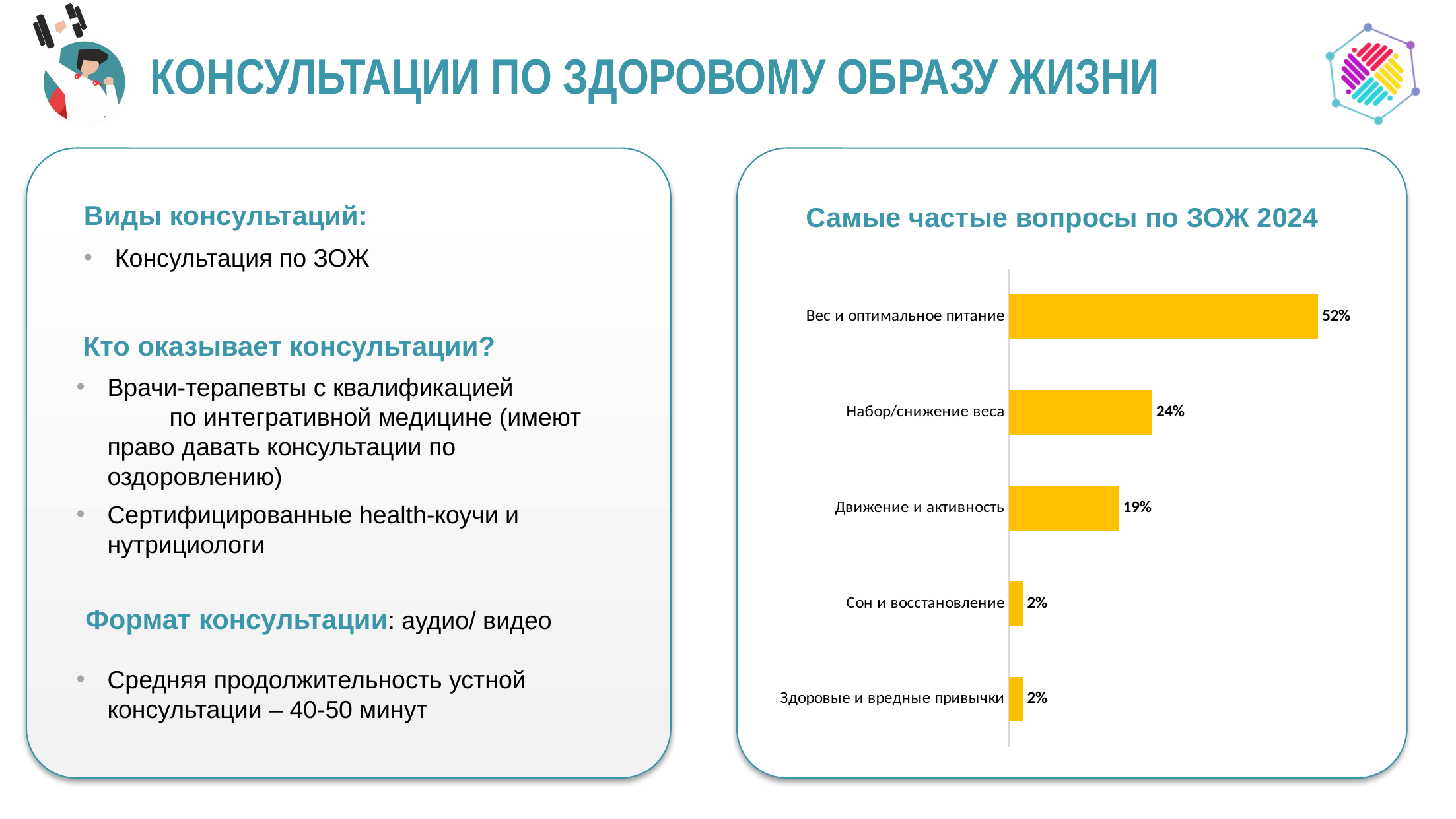
How many categories are shown in the chart? 5 What colour are the bars in the chart? Yellow Which category has the highest value? Вес и оптимальное питание What kind of chart is shown on the slide? Bar chart What is the value for Вес и оптимальное питание? 52% What is the value for Набор/снижение веса? 24% Which is larger, Движение и активность or Сон и восстановление? Движение и активность What is the difference between Вес и оптимальное питание and Набор/снижение веса? 28% What is the title of the chart? Самые частые вопросы по ЗОЖ 2024 What is the difference between Набор/снижение веса and Движение и активность? 5% What is the value for Сон и восстановление? 2% What is the value for Движение и активность? 19%